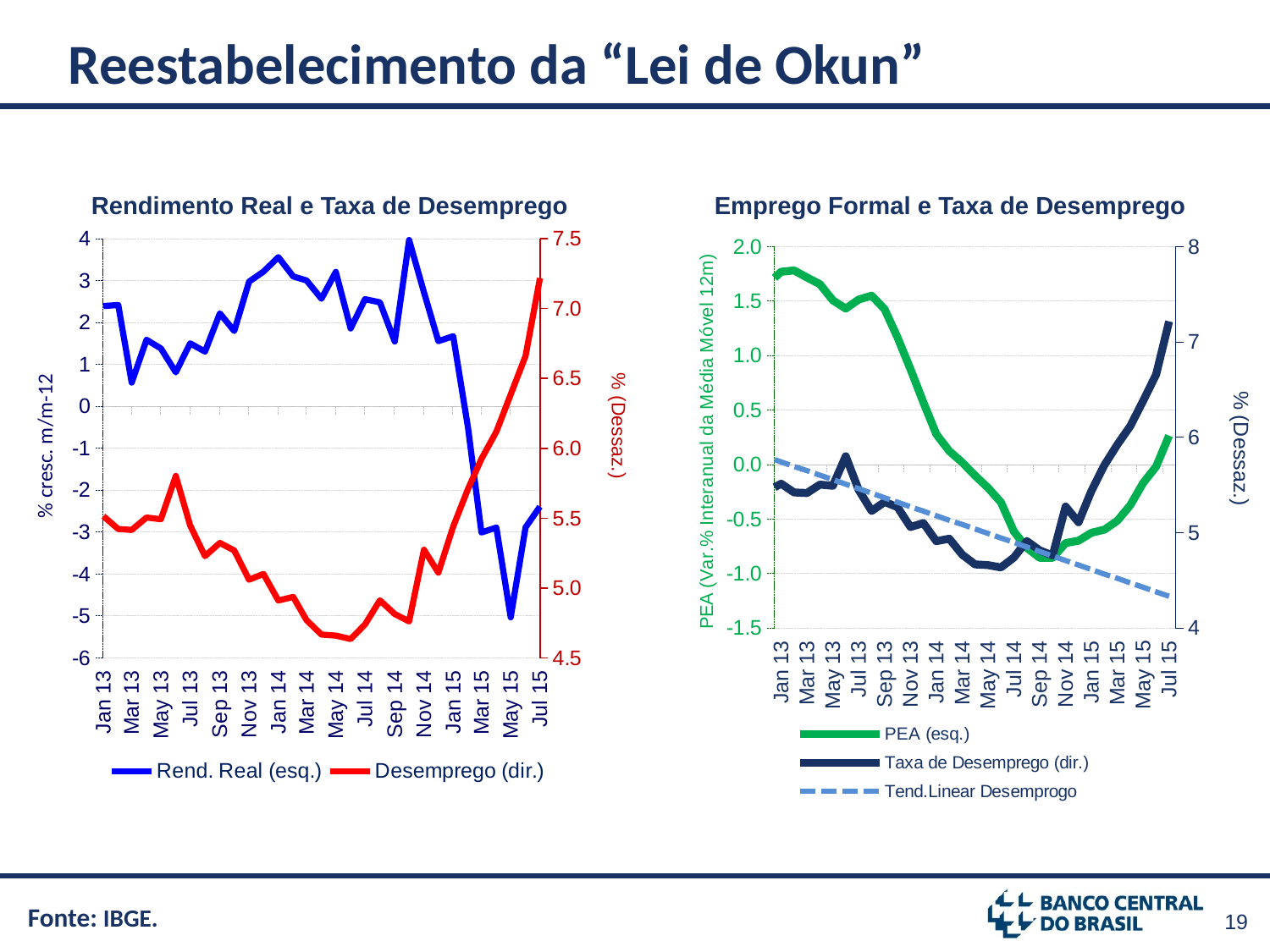
How many series does the legend of the left chart, 'Rendimento Real e Taxa de Desemprego', list? 2 In the left chart, 'Rendimento Real e Taxa de Desemprego', is the value of Desemprego (dir.) in May 14 greater or less than 5.0? less In the right chart, 'Emprego Formal e Taxa de Desemprego', is the value of PEA (esq.) in Jan 13 greater or less than 1.5? greater How many series does the legend of the right chart, 'Emprego Formal e Taxa de Desemprego', list? 3 In the left chart, 'Rendimento Real e Taxa de Desemprego', is the value of Desemprego (dir.) in Jul 15 greater or less than 7.0? greater In the left chart, 'Rendimento Real e Taxa de Desemprego', in which month does Rend. Real (esq.) reach its highest value? Oct 14 What kind of chart is the left chart, 'Rendimento Real e Taxa de Desemprego'? line chart In the right chart, 'Emprego Formal e Taxa de Desemprego', which series is drawn as a dashed line? Tend.Linear Desemprogo In the right chart, 'Emprego Formal e Taxa de Desemprego', does PEA (esq.) overall rise or fall from Jan 13 to Jul 15? fall In the left chart, 'Rendimento Real e Taxa de Desemprego', does Rend. Real (esq.) overall rise or fall from Jan 13 to Jul 15? fall